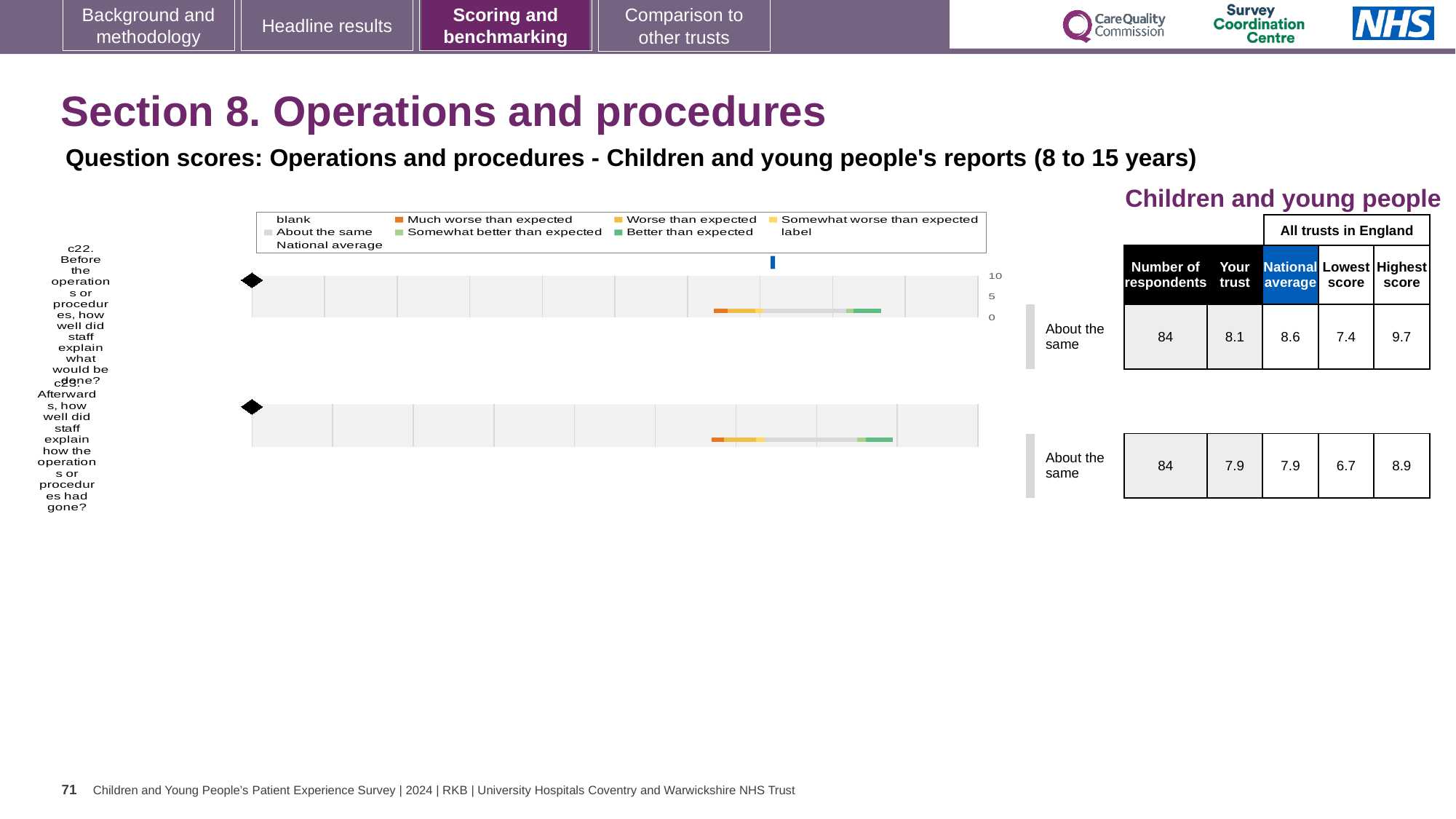
For question c22, which is larger: the 'Your trust' score or the national average? National average How many questions (bars) are plotted in the chart? 2 What is the difference between the highest and lowest scores for question c22? 2.3 In the chart legend, what colour represents 'Much worse than expected'? orange What is the highest score among all trusts in England for question c22? 9.7 What is the national average score for question c22? 8.6 What is the 'Your trust' score for question c23 (Afterwards, how well did staff explain how the operations or procedures had gone?)? 7.9 What is the lowest score among all trusts in England for question c23? 6.7 What is the 'Your trust' score for question c22 (Before the operations or procedures, how well did staff explain what would be done?)? 8.1 How many respondents answered question c23? 84 What kind of chart is used to show the question scores on this slide? bar chart What is the maximum value shown on the chart's score axis? 10